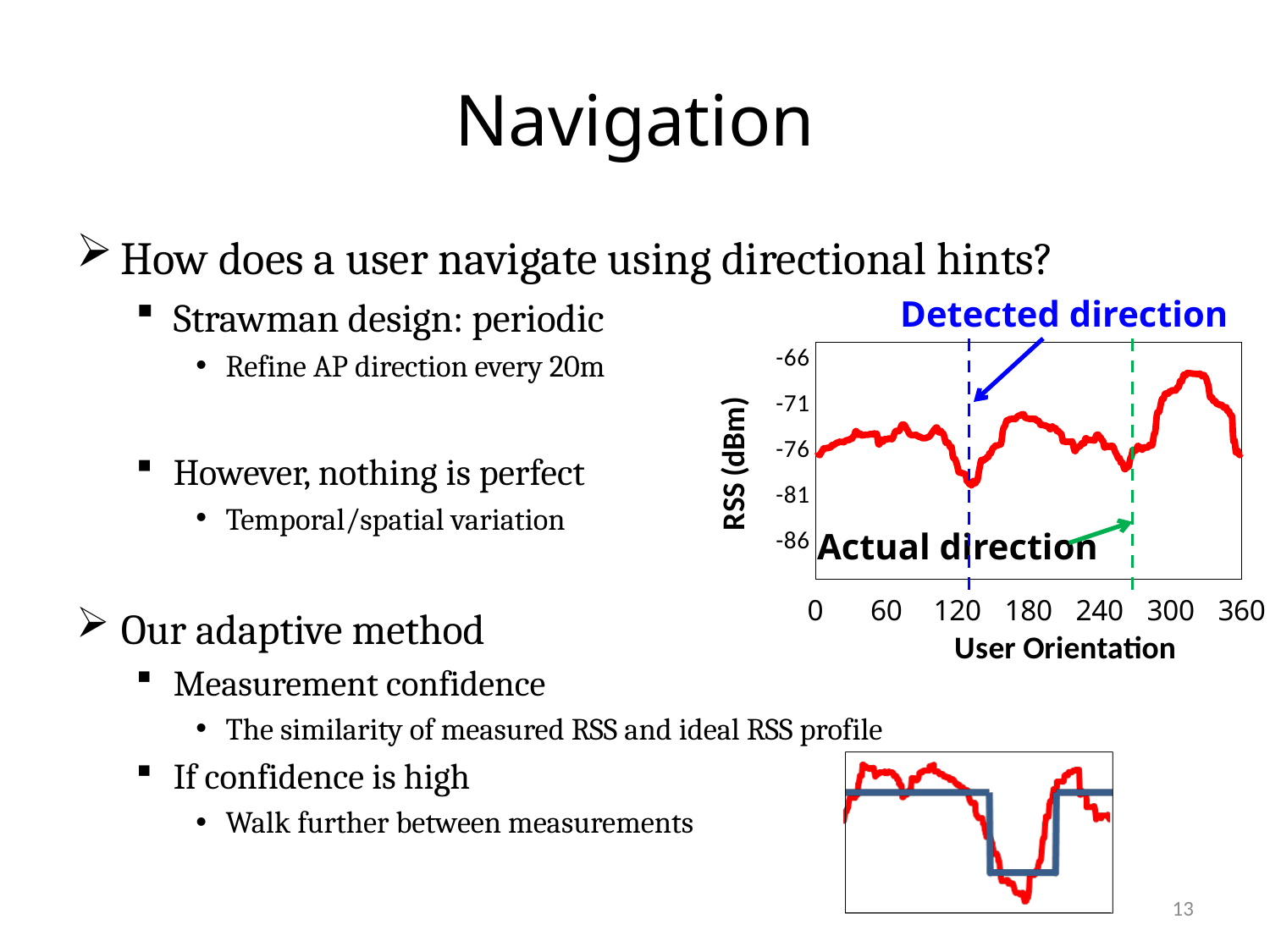
On the RSS chart, what is the label of the y axis? RSS (dBm) On the RSS chart, is the RSS value at a user orientation of 300 larger or smaller than the value at the detected direction (blue dashed line)? larger On the RSS chart, what is the largest value shown on the User Orientation axis? 360 On the RSS chart, does the RSS value rise or fall as user orientation goes from 270 to 310? rise On the RSS chart, what does the blue dashed vertical line mark? Detected direction On the RSS chart, what is the lowest tick value shown on the RSS (dBm) axis? -86 On the RSS chart, is the RSS value at the detected direction (blue dashed line) greater or less than -76? less On the RSS chart, is the RSS value at a user orientation of 60 greater or less than -71? less What kind of chart is the RSS vs User Orientation chart on the slide? line chart On the RSS chart, is the RSS value at a user orientation of 300 greater or less than -71? greater On the RSS chart, does the RSS value rise or fall as user orientation goes from 100 to 130? fall On the RSS chart, how many tick labels are shown on the User Orientation axis? 7